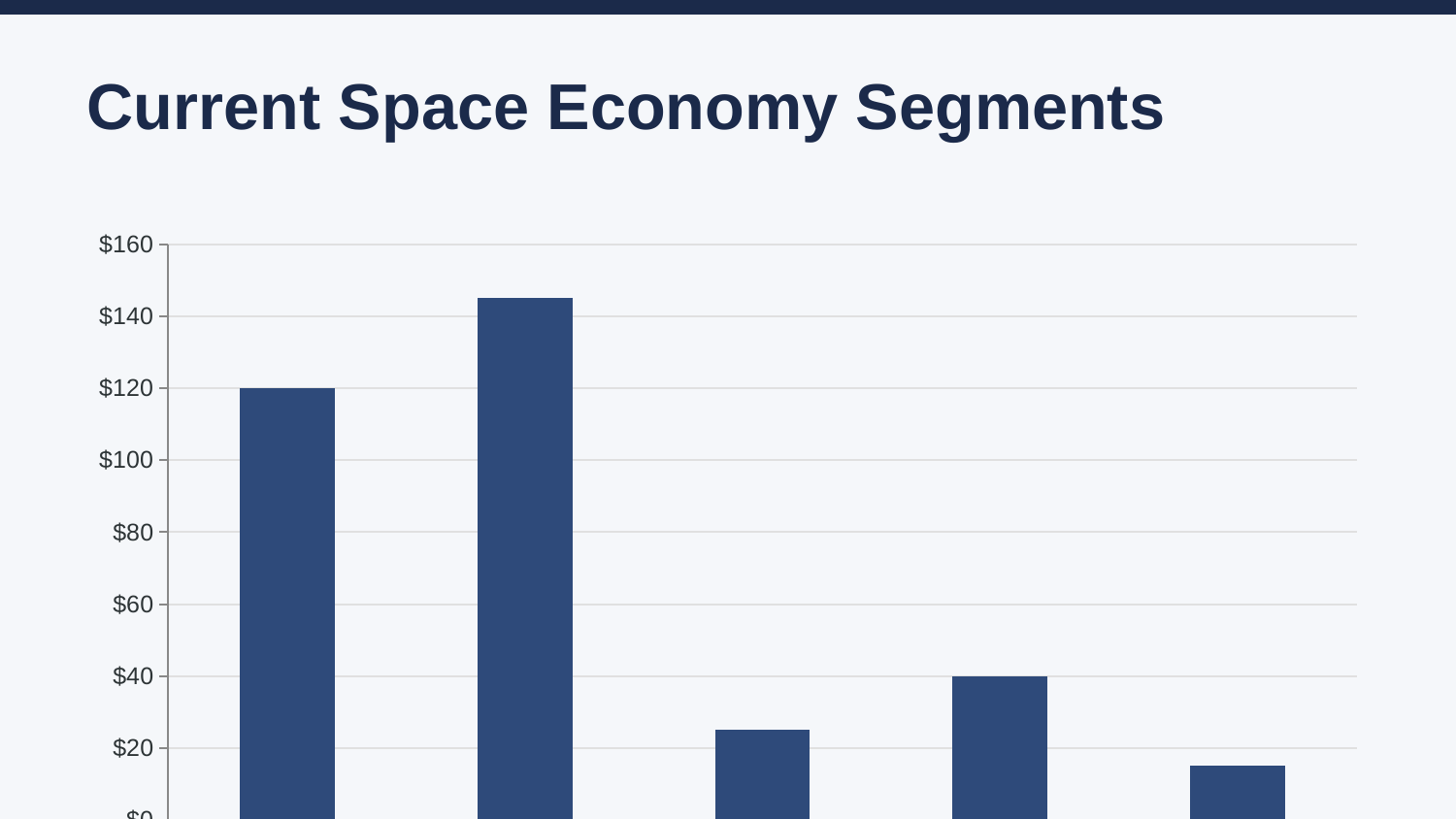
What is the difference between the first bar and the fourth bar? $80 Which bar is the shortest in the chart? the fifth bar What kind of chart is shown on the slide? bar chart Is the value of the second bar greater or less than $140? greater What is the value of the first bar in the chart? $120 Which bar is the tallest in the chart? the second bar How many bars are plotted in the chart? 5 Is the value of the third bar greater or less than $40? less What is the value of the fourth bar in the chart? $40 Which is larger, the first bar or the second bar? the second bar Is the value of the fifth bar greater or less than $20? less What is the title of the slide containing the chart? Current Space Economy Segments